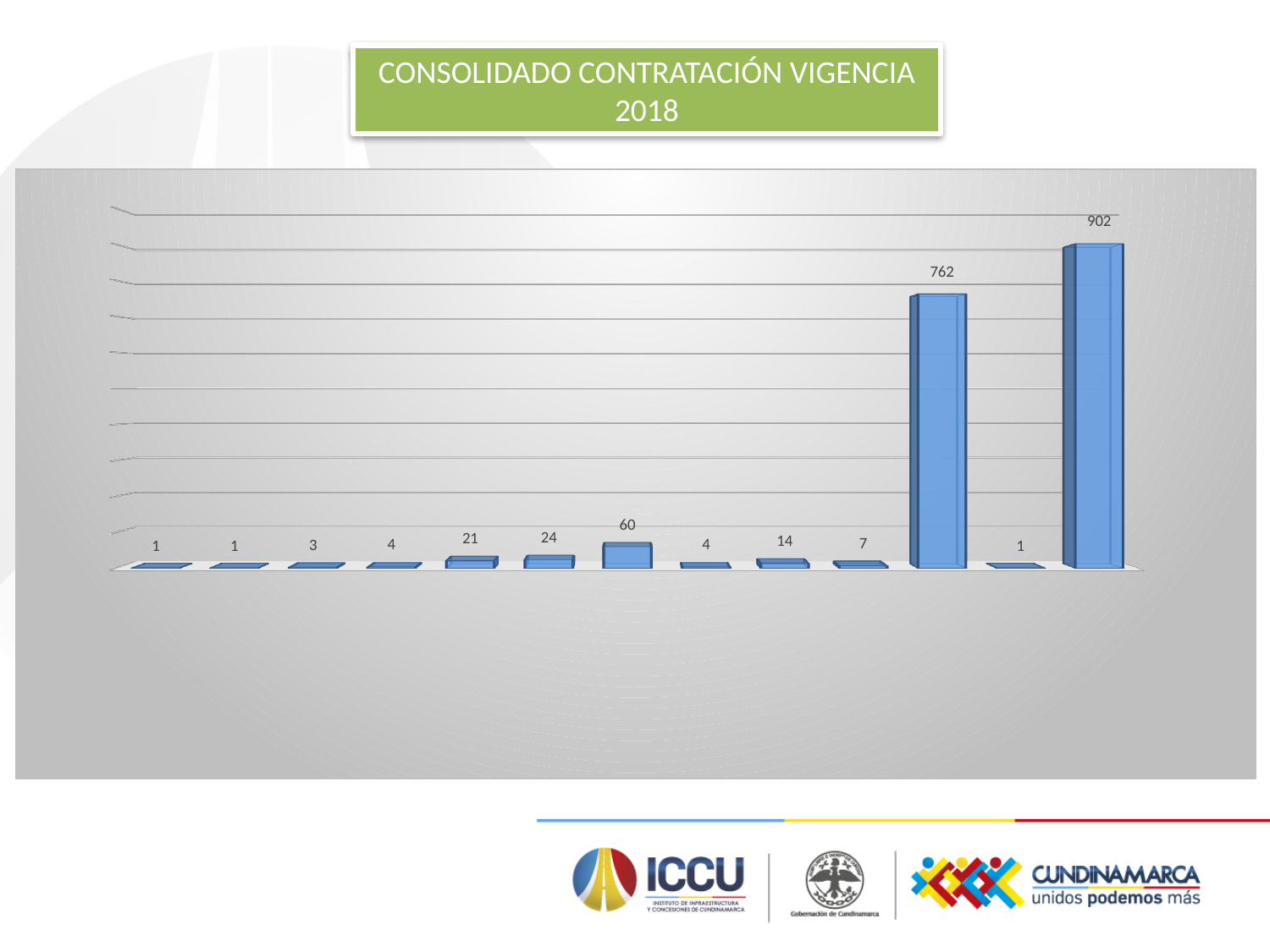
What is the difference between the bar labelled 60 and the bar labelled 24? 36 What is the value of the seventh bar from the left? 60 What is the value of the rightmost bar in the chart? 902 What is the difference between the two tallest bars (902 and 762)? 140 What is the value of the second-tallest bar in the chart? 762 What is the highest value shown in the chart? 902 What kind of chart is shown on the slide? bar chart How many bars are plotted in the chart? 13 Which is larger, the fifth bar from the left (21) or the sixth bar from the left (24)? 24 How many bars in the chart have a value of 1? 3 What is the title shown above the chart? CONSOLIDADO CONTRATACIÓN VIGENCIA 2018 What is the lowest value shown in the chart? 1